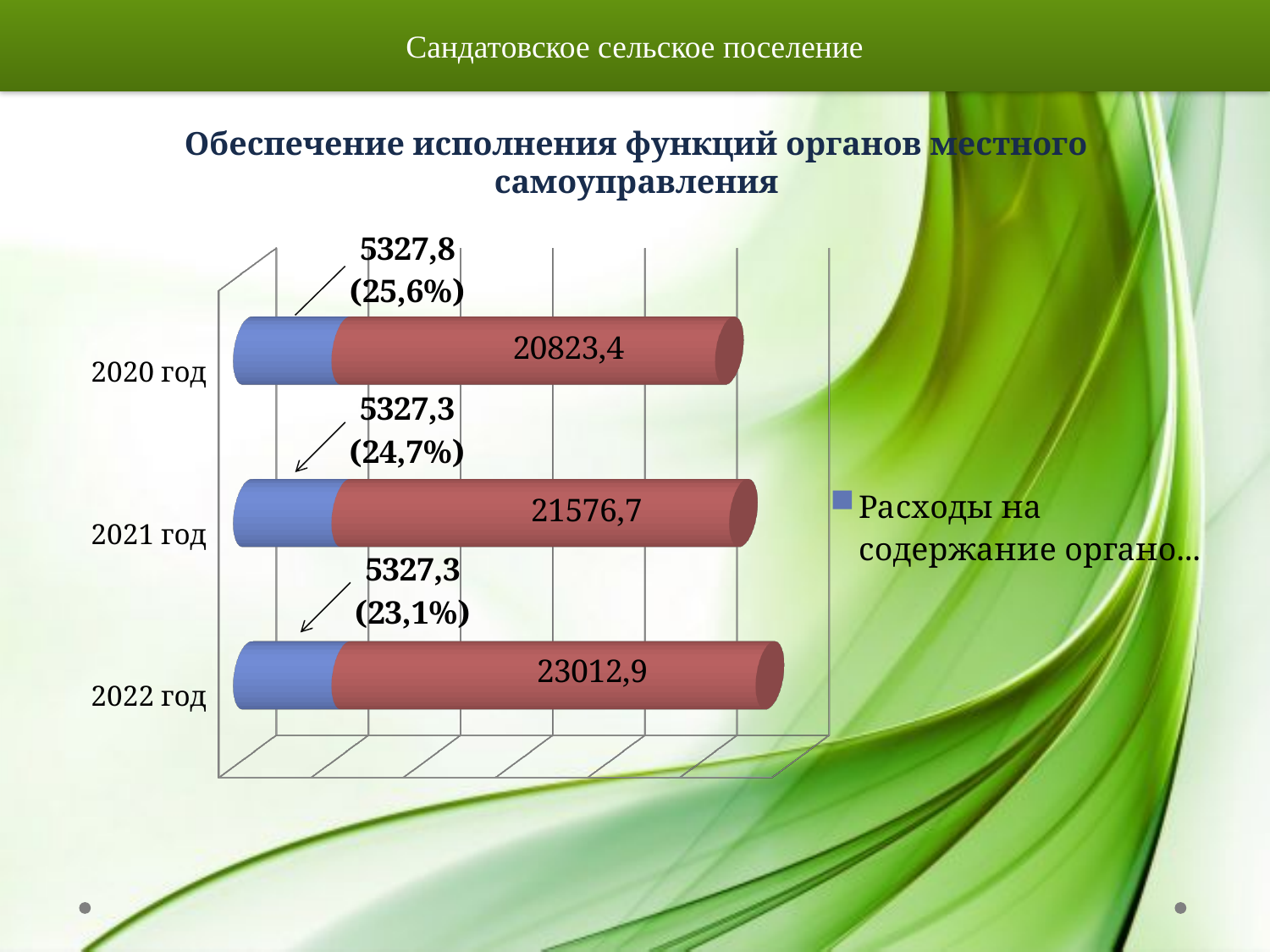
What is the difference between the red segment values for 2022 год and 2021 год? 1436,2 Is the red segment larger for 2022 год or for 2020 год? 2022 год What is the value of the blue segment for 2021 год? 5327,3 How many years are shown on the chart? 3 Do the red segment values rise or fall from 2020 год to 2022 год? Rise What percentage is shown in parentheses next to the blue segment for 2022 год? 23,1% What is the value of the red segment for 2020 год? 20823,4 What is the title of the chart? Обеспечение исполнения функций органов местного самоуправления Which year has the smallest red segment? 2020 год What kind of chart is shown on the slide? Bar chart Which year has the largest red segment? 2022 год What is the total of the stacked bar for 2020 год? 26151,2